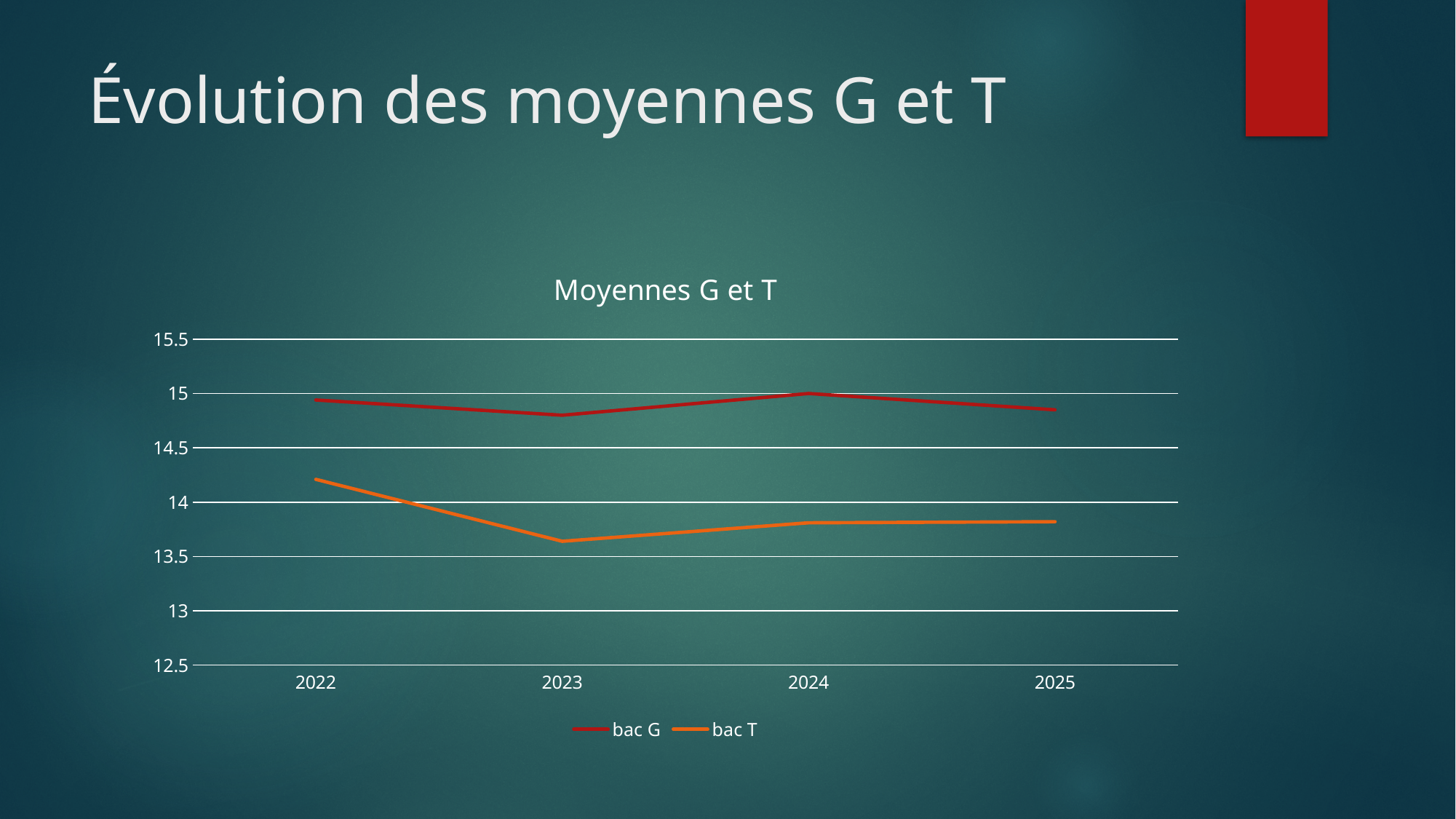
Is the value for bac G in 2022 greater or less than 14.5? greater How many years are plotted along the x axis? 4 Is the value for bac T in 2023 greater or less than 14? less Which series is drawn in orange? bac T Is the value for bac G in 2023 greater or less than 15? less What kind of chart is shown on the slide? line chart In which year is the bac T series at its lowest? 2023 Which series has the higher value in 2024, bac G or bac T? bac G How many series does the legend list? 2 What is the title of the chart? Moyennes G et T In which year is the bac T series at its highest? 2022